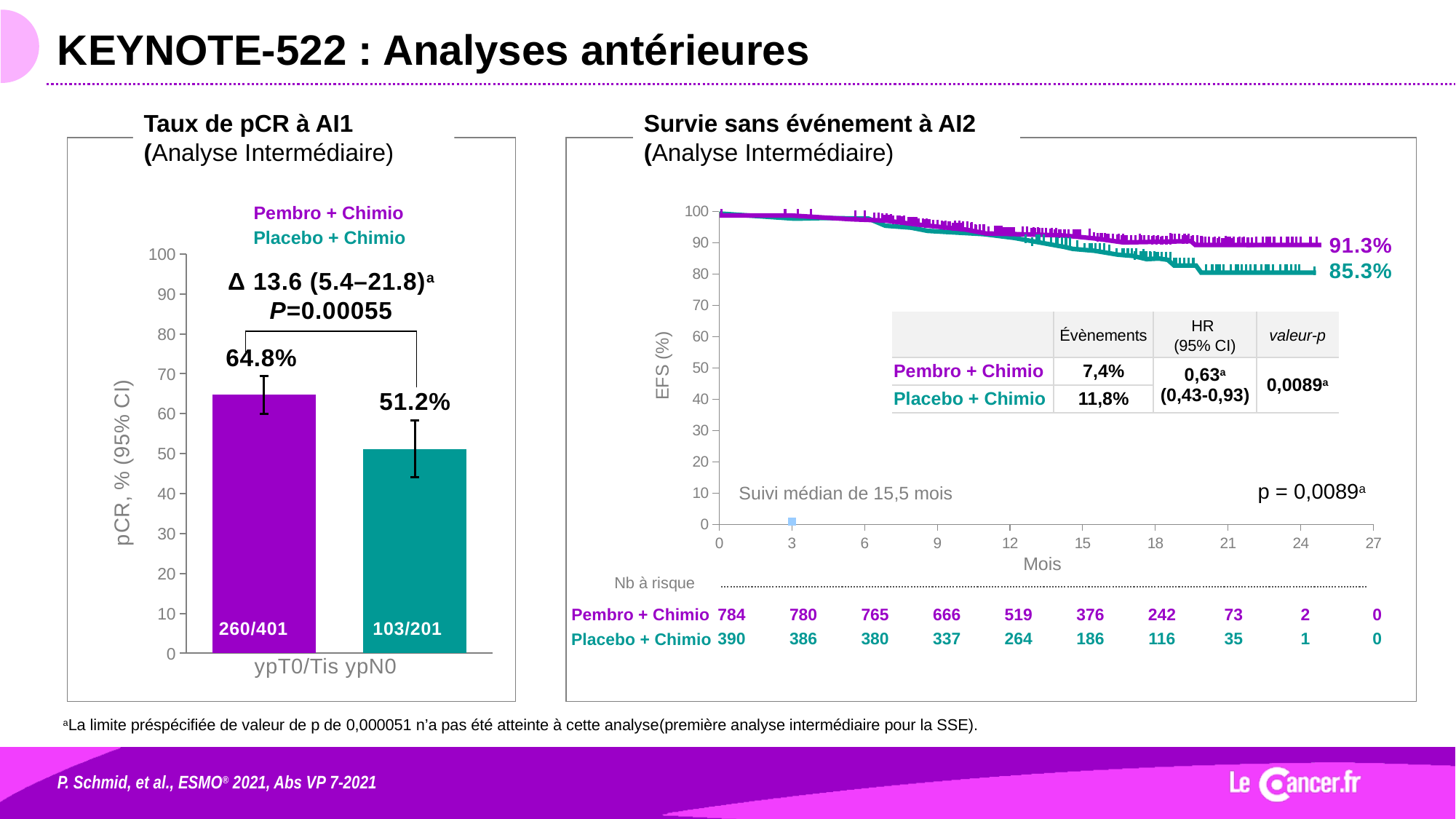
In the 'Taux de pCR à AI1' chart, which arm has the higher pCR rate? Pembro + Chimio In the 'Taux de pCR à AI1' chart, what is the difference in pCR rate between Pembro + Chimio and Placebo + Chimio? 13.6 In the 'Survie sans événement à AI2' chart, what is the hazard ratio (95% CI) shown in the table? 0,63 (0,43-0,93) In the 'Taux de pCR à AI1' chart, what fraction of patients is shown inside the Placebo + Chimio bar? 103/201 In the 'Survie sans événement à AI2' chart, how many Placebo + Chimio patients were at risk at 12 months? 264 In the 'Survie sans événement à AI2' chart, do the EFS curves rise or fall over time? Fall How many bars are plotted in the 'Taux de pCR à AI1' chart? 2 In the 'Survie sans événement à AI2' chart, what is the EFS rate shown at the end of the Pembro + Chimio curve? 91.3% What kind of chart is the 'Taux de pCR à AI1' chart? Bar chart In the 'Taux de pCR à AI1' chart, what is the pCR rate for Pembro + Chimio? 64.8% In the 'Taux de pCR à AI1' chart, what is the pCR rate for Placebo + Chimio? 51.2% In the 'Survie sans événement à AI2' chart, what is the EFS rate shown at the end of the Placebo + Chimio curve? 85.3%